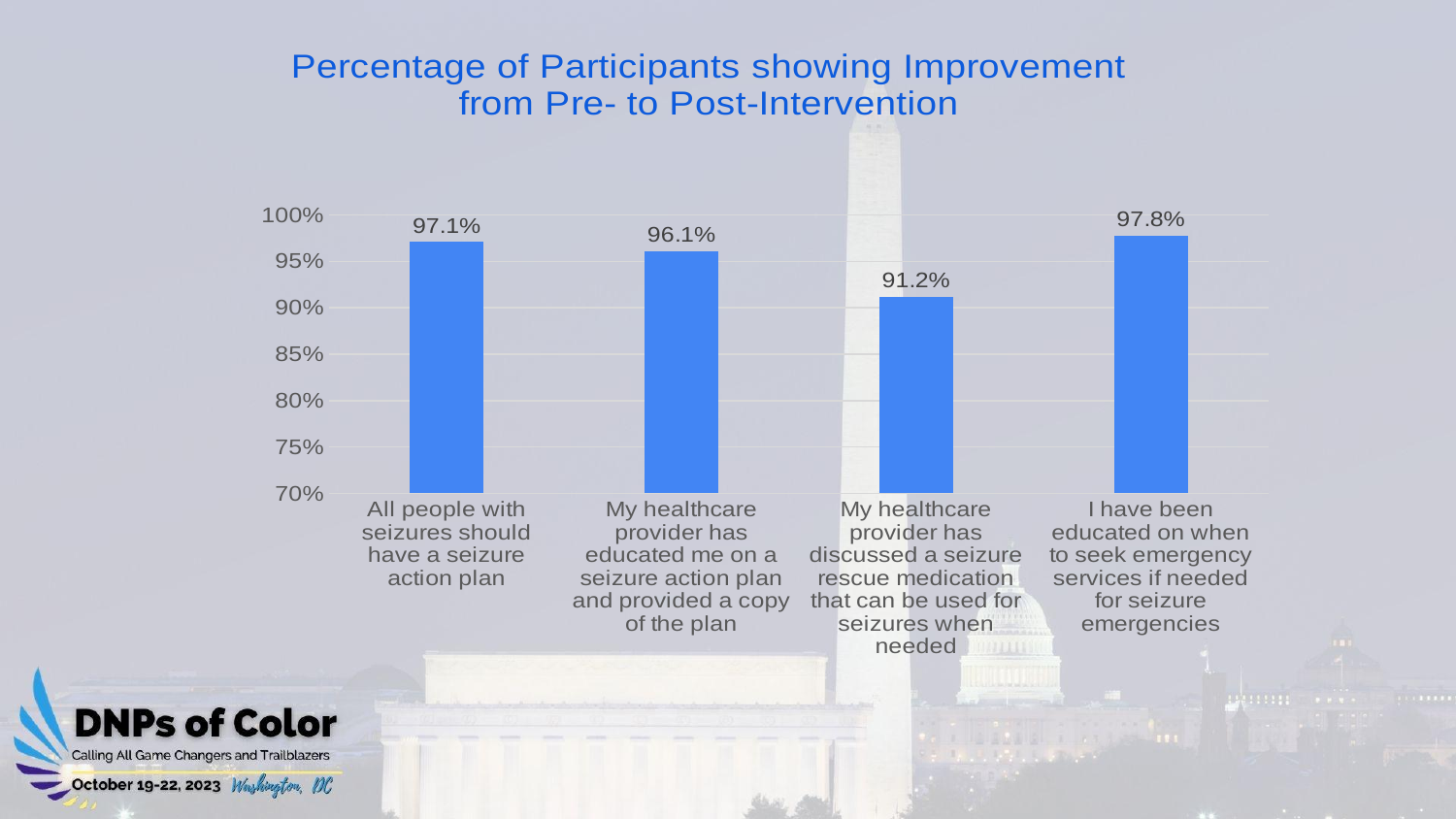
Which is larger: the value for "All people with seizures should have a seizure action plan" or the value for "My healthcare provider has educated me on a seizure action plan and provided a copy of the plan"? All people with seizures should have a seizure action plan How many categories are shown in the chart? 4 What is the title of the chart? Percentage of Participants showing Improvement from Pre- to Post-Intervention What is the value for "My healthcare provider has discussed a seizure rescue medication that can be used for seizures when needed"? 91.2% What kind of chart is shown on the slide? Bar chart What is the difference between the values for "All people with seizures should have a seizure action plan" and "My healthcare provider has educated me on a seizure action plan and provided a copy of the plan"? 1.0% What percentage of participants showed improvement for "All people with seizures should have a seizure action plan"? 97.1% Which category has the lowest percentage of participants showing improvement? My healthcare provider has discussed a seizure rescue medication that can be used for seizures when needed Which category has the highest percentage of participants showing improvement? I have been educated on when to seek emergency services if needed for seizure emergencies What is the value for "I have been educated on when to seek emergency services if needed for seizure emergencies"? 97.8% What is the difference between the highest and lowest values shown in the chart? 6.6% Is the value for "My healthcare provider has discussed a seizure rescue medication that can be used for seizures when needed" greater or less than 95%? less